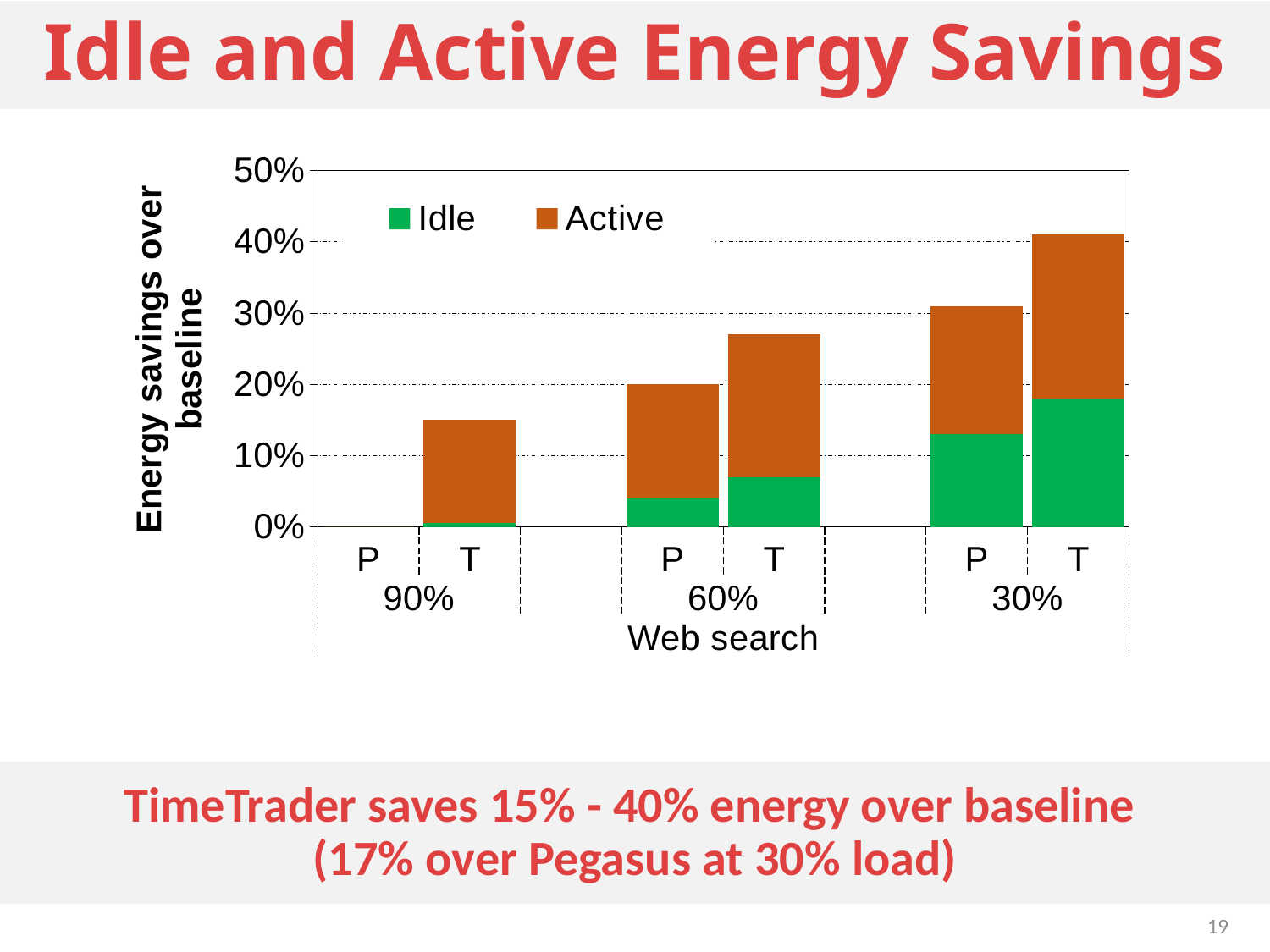
How many series does the legend list? 2 What kind of chart is shown on the slide? stacked bar chart As the load goes from 90% to 30% along the x axis, do the total energy savings for T rise or fall? rise At 60% load, which has larger total energy savings, P or T? T Is the total energy savings for P at 60% load greater or less than 30%? less Which bar has the lowest total energy savings over baseline? P at 90% load Is the total energy savings for T at 90% load greater or less than 20%? less Which bar has the highest total energy savings over baseline? T at 30% load What are the two series named in the legend? Idle and Active Is the total energy savings for T at 60% load greater or less than 20%? greater